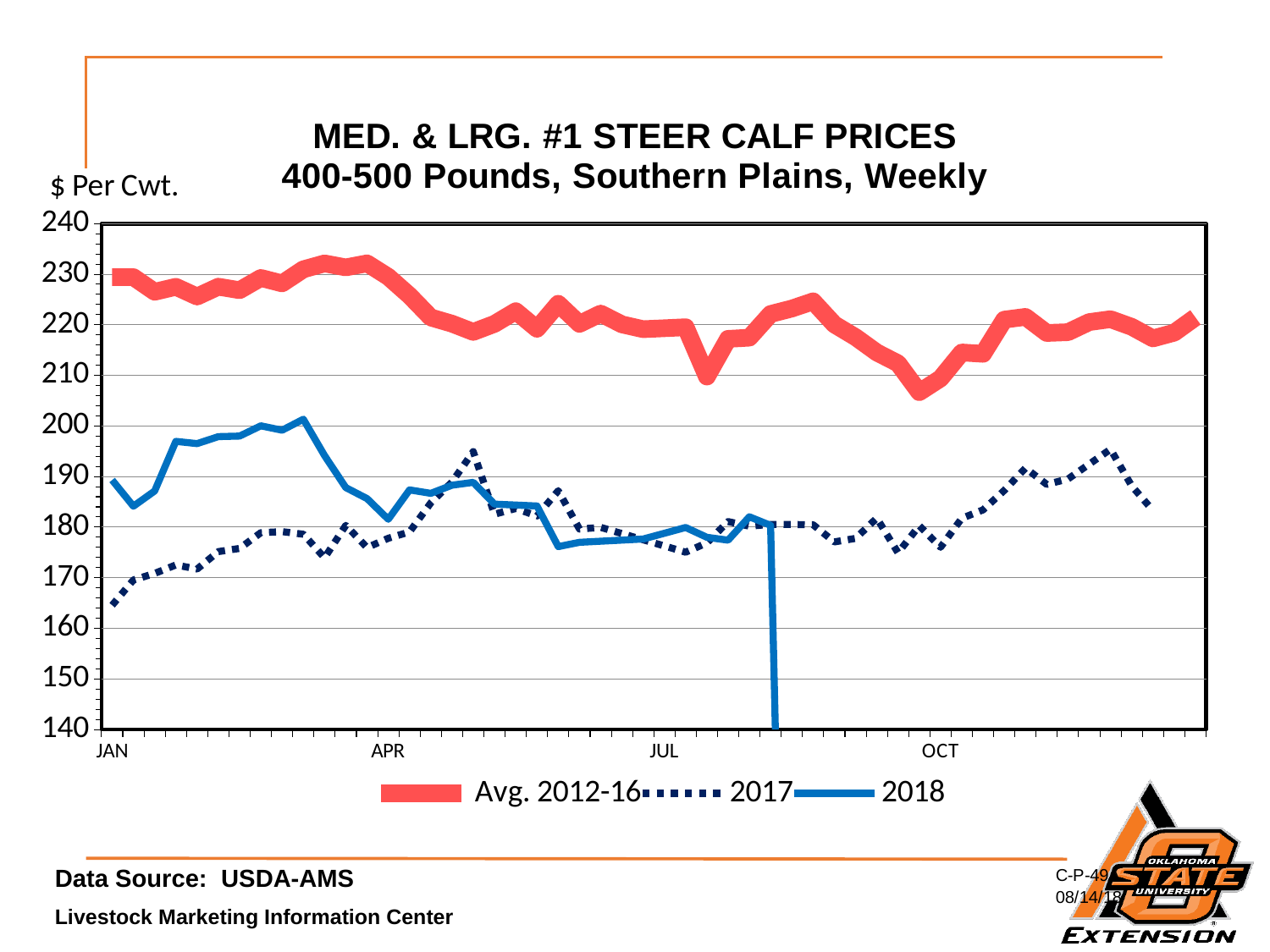
Is the value for 2018 in January greater or less than 180? greater Which series has the lowest value in January? 2017 Which series has the highest values across the whole year? Avg. 2012-16 Is the value for 2017 in January greater or less than 170? less How many series does the legend list? 3 Is the value for Avg. 2012-16 in January greater or less than 220? greater In January, which is higher, the 2018 line or the 2017 line? 2018 What kind of chart is shown on the slide? line chart What is the unit shown on the y axis of the chart? $ Per Cwt. Which series is drawn with a dotted line? 2017 Does the 2017 line rise or fall from January to April? rise